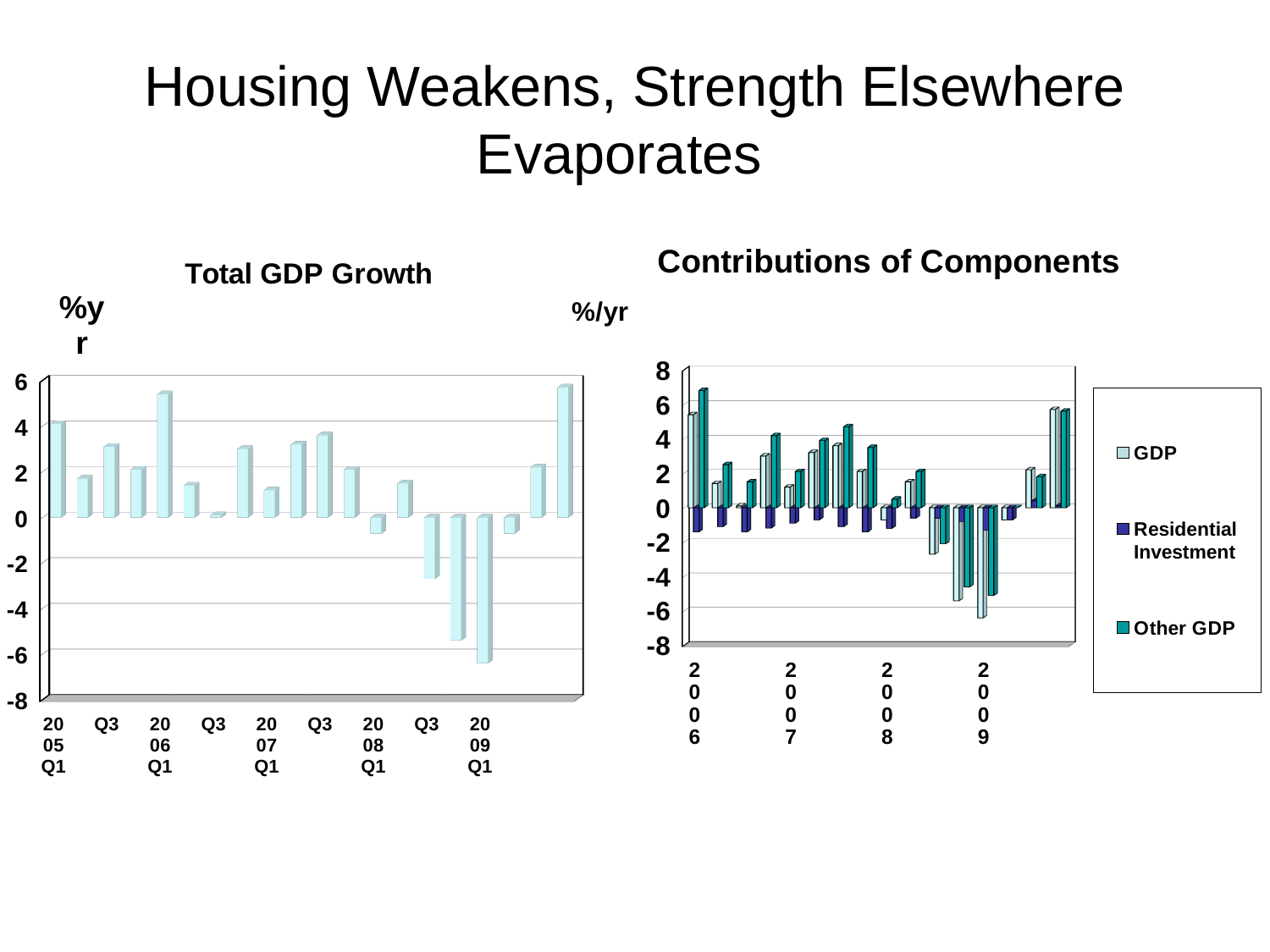
In the "Total GDP Growth" chart, is the value for 2009 Q1 greater or less than -4? less What kind of chart is the "Contributions of Components" chart on the right? bar chart What kind of chart is the "Total GDP Growth" chart on the left? bar chart In the "Total GDP Growth" chart, which is larger, the value for 2005 Q1 or the value for 2007 Q1? 2005 Q1 What are the series names in the legend of the "Contributions of Components" chart? GDP, Residential Investment, Other GDP In the "Total GDP Growth" chart, is the value for 2008 Q3 greater or less than 0? less In the "Total GDP Growth" chart, which quarter has the lowest value? 2009 Q1 In the "Total GDP Growth" chart, what is the lowest value shown on the y axis? -8 In the "Total GDP Growth" chart, is the value for 2005 Q1 greater or less than 2? greater How many series does the legend of the "Contributions of Components" chart list? 3 What is the y-axis unit label shown on the "Contributions of Components" chart? %/yr